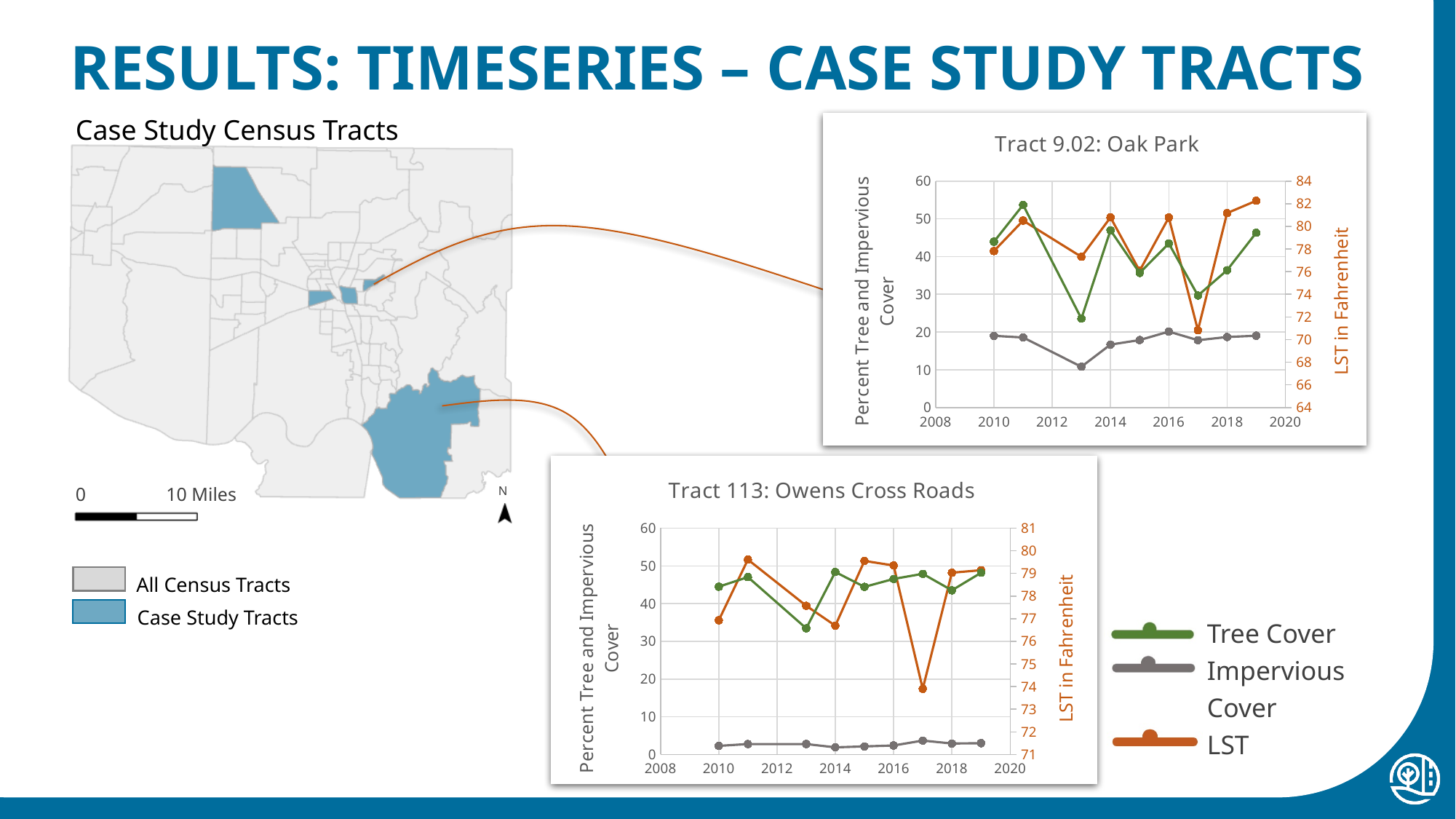
In the 'Tract 9.02: Oak Park' chart, which year has the lowest LST value? 2017 What kind of chart is 'Tract 9.02: Oak Park'? line chart In the 'Tract 9.02: Oak Park' chart, is the Impervious Cover value for 2013 greater or less than 15? less In the 'Tract 9.02: Oak Park' chart, which year has the lowest Tree Cover value? 2013 In the 'Tract 9.02: Oak Park' chart, which year has the highest Tree Cover value? 2011 How many series does the legend list for the timeseries charts? 3 In the 'Tract 113: Owens Cross Roads' chart, is the Impervious Cover value for 2010 greater or less than 10? less In the 'Tract 9.02: Oak Park' chart, which year has the larger Tree Cover value, 2011 or 2013? 2011 In the 'Tract 113: Owens Cross Roads' chart, which year has the lowest Tree Cover value? 2013 What is the label of the right-hand vertical axis in the 'Tract 113: Owens Cross Roads' chart? LST in Fahrenheit In the 'Tract 9.02: Oak Park' chart, is the Tree Cover value for 2013 greater or less than 30? less